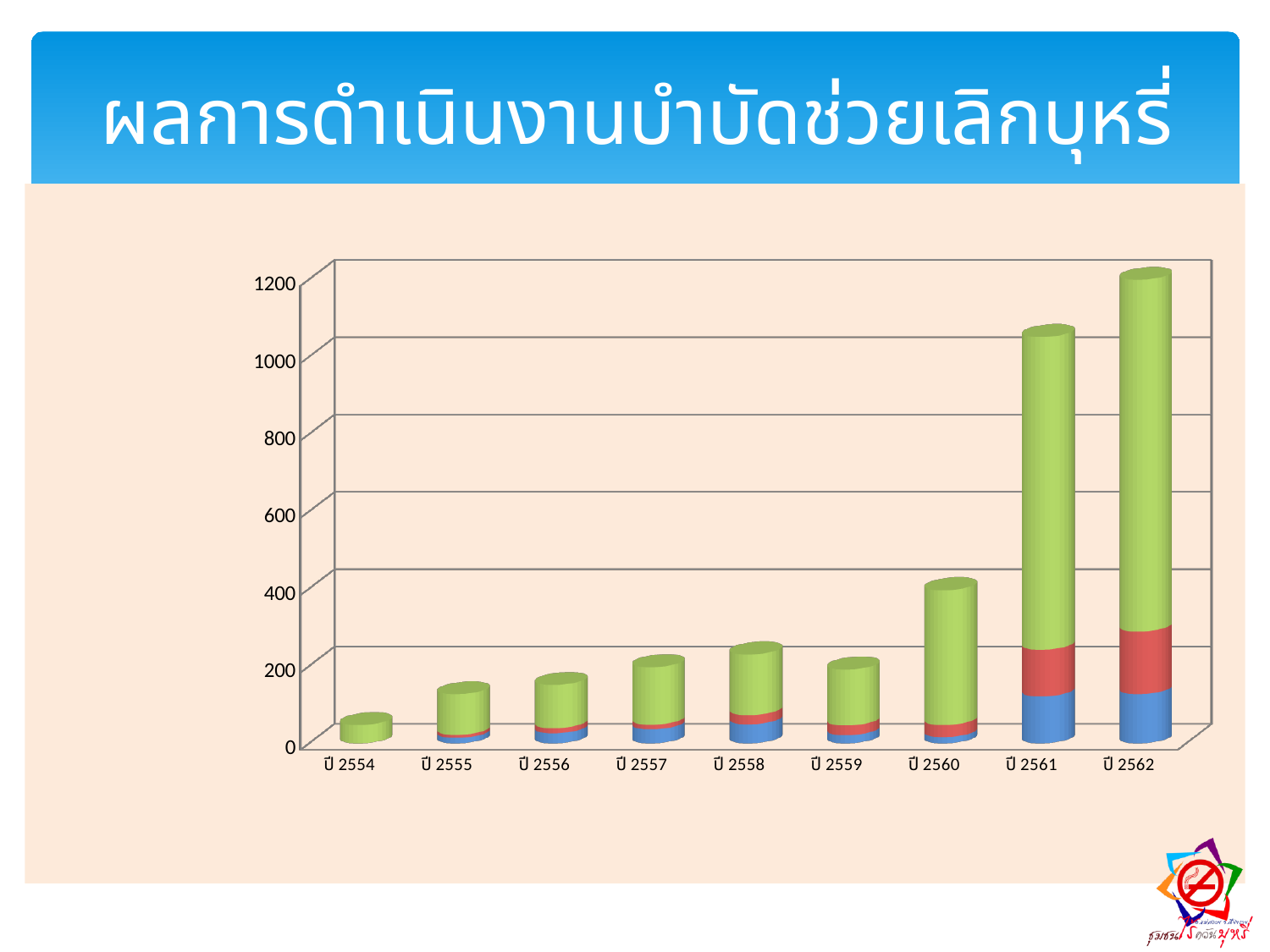
Is the total bar height for ปี 2555 greater or less than 400? less Overall, do the bar totals rise or fall from ปี 2554 to ปี 2562? rise Is the total bar height for ปี 2562 greater or less than 1000? greater Which bar is taller, ปี 2558 or ปี 2559? ปี 2558 Which year has the tallest bar in the chart? ปี 2562 Which year has the shortest bar in the chart? ปี 2554 What kind of chart is shown on the slide? Stacked bar chart What is the title of the slide containing the chart? ผลการดำเนินงานบำบัดช่วยเลิกบุหรี่ Is the total bar height for ปี 2561 greater or less than 800? greater How many year categories are shown on the x axis of the chart? 9 Which bar is taller, ปี 2560 or ปี 2561? ปี 2561